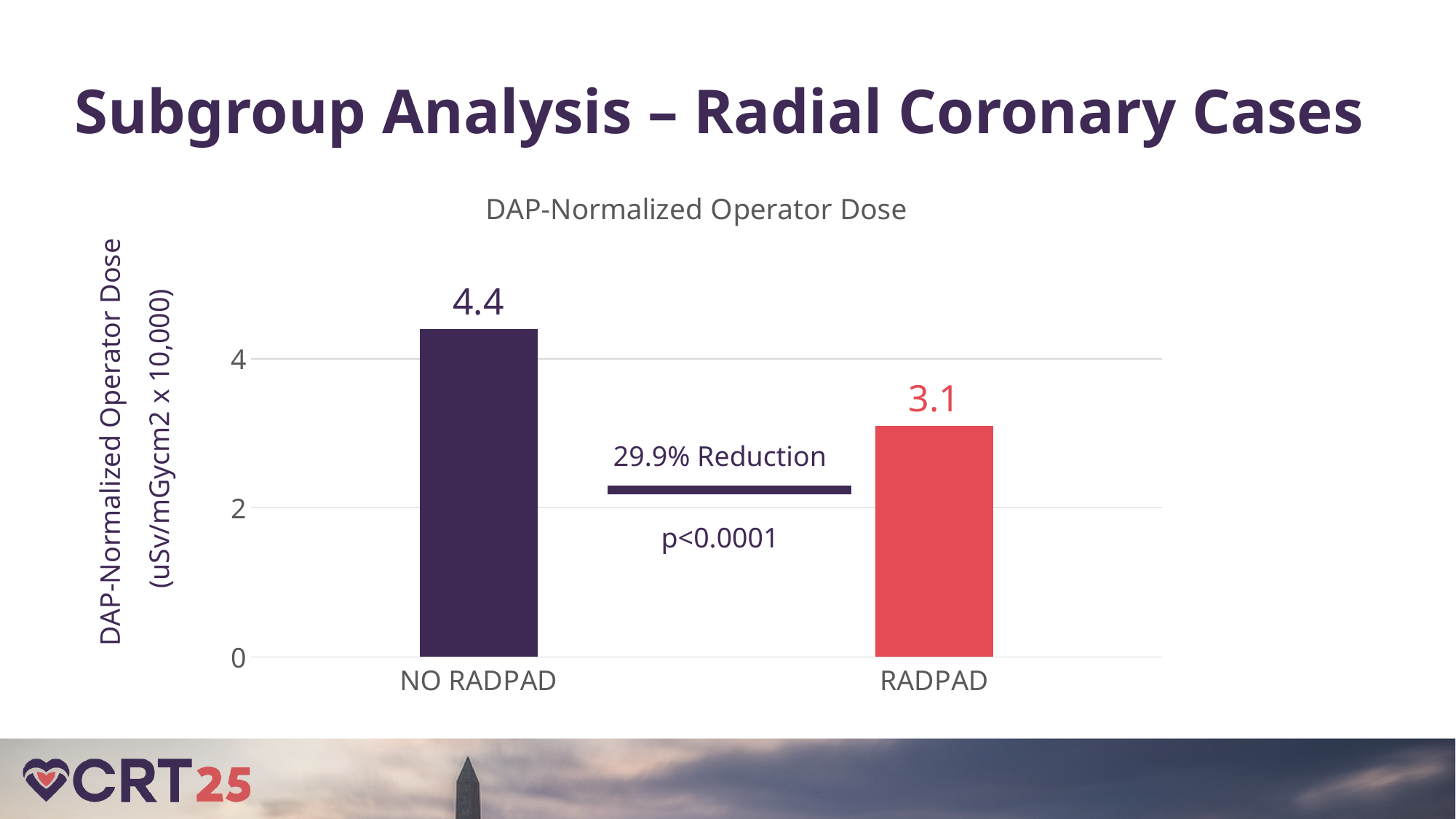
Is the value for RADPAD greater or less than 4? less What is the difference between the NO RADPAD and RADPAD values? 1.3 Which category has the lowest DAP-Normalized Operator Dose? RADPAD What percentage reduction is annotated between the two bars? 29.9% Reduction What is the title of the chart? DAP-Normalized Operator Dose Which category has the highest DAP-Normalized Operator Dose? NO RADPAD Is the value for NO RADPAD greater or less than 4? greater What kind of chart is shown on the slide? Bar chart What is the DAP-Normalized Operator Dose value for NO RADPAD? 4.4 How many categories are shown on the x axis of the chart? 2 What is the DAP-Normalized Operator Dose value for RADPAD? 3.1 Which is larger, the value for NO RADPAD or the value for RADPAD? NO RADPAD